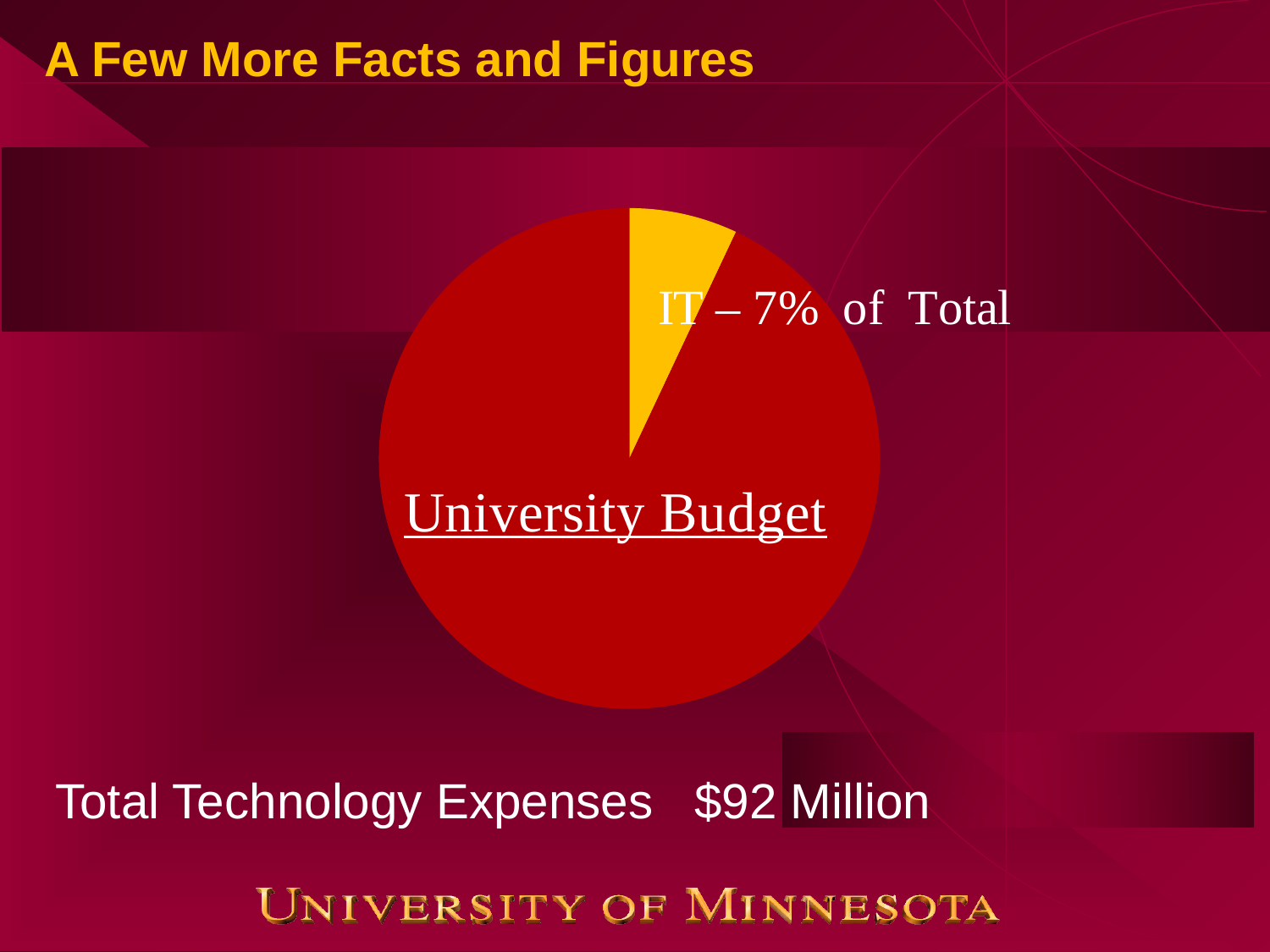
What does the pie chart as a whole represent, according to its label? University Budget What share of the pie is not IT? 93% How many slices does the pie chart have? 2 What share of the total University Budget does the IT slice represent? 7% What colour is the IT slice in the pie chart? yellow Which slice of the pie chart is the smallest? IT Which slice of the pie chart is larger, the IT slice or the rest of the University Budget? the rest of the University Budget What kind of chart is shown on the slide? pie chart